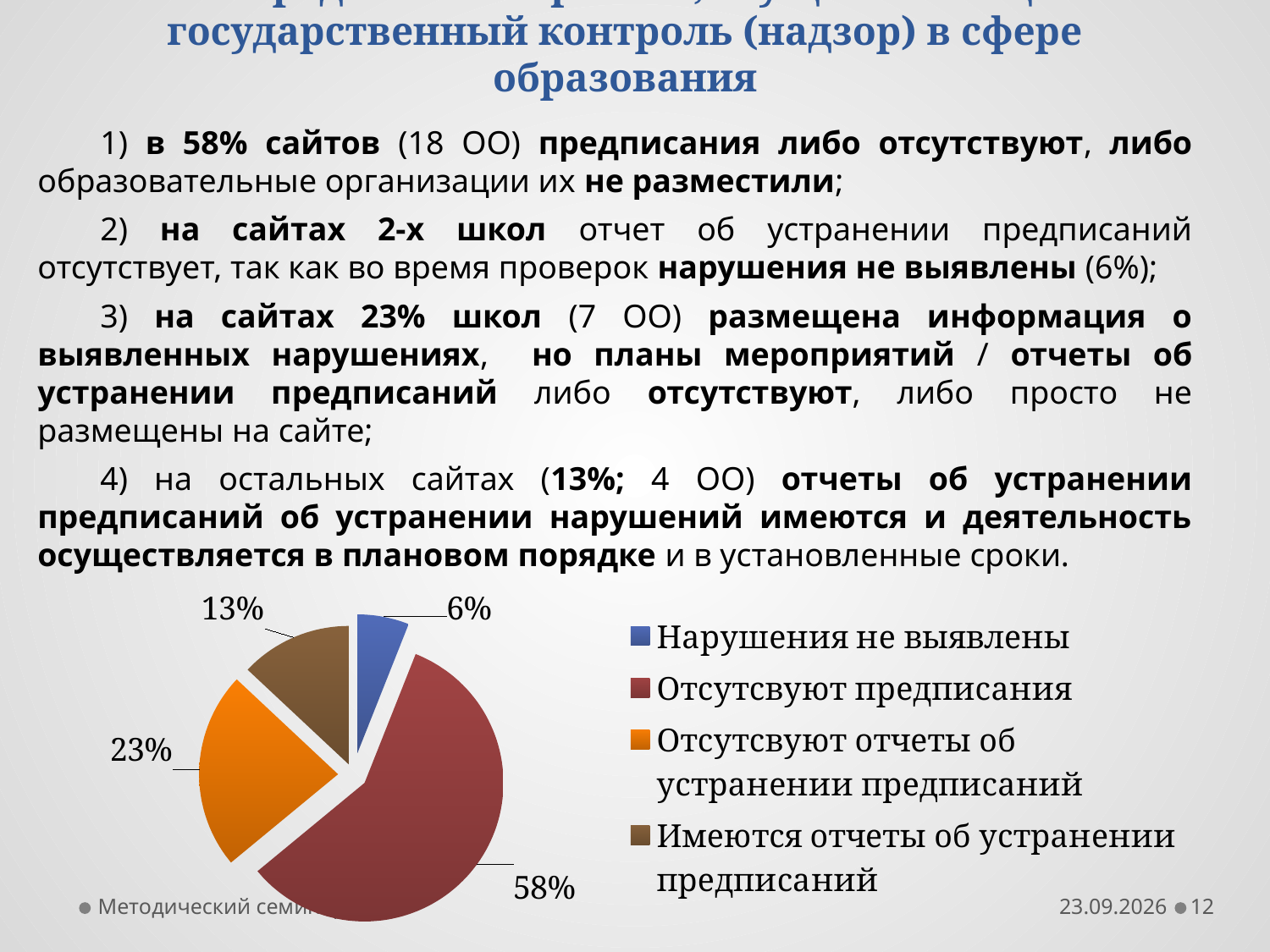
How many slices does the pie chart have? 4 What share of the pie does the slice "Отсутсвуют предписания" represent? 58% Which category has the smallest slice in the pie chart? Нарушения не выявлены How many entries does the legend of the pie chart list? 4 What colour is the slice for "Нарушения не выявлены" in the pie chart? blue What share of the pie does the slice "Нарушения не выявлены" represent? 6% What share of the pie does the slice "Отсутсвуют отчеты об устранении предписаний" represent? 23% Which category has the largest slice in the pie chart? Отсутсвуют предписания Which slice is larger: "Имеются отчеты об устранении предписаний" or "Отсутсвуют отчеты об устранении предписаний"? Отсутсвуют отчеты об устранении предписаний What is the difference in percentage points between the "Отсутсвуют предписания" slice and the "Отсутсвуют отчеты об устранении предписаний" slice? 35 What kind of chart is shown on the slide? pie chart